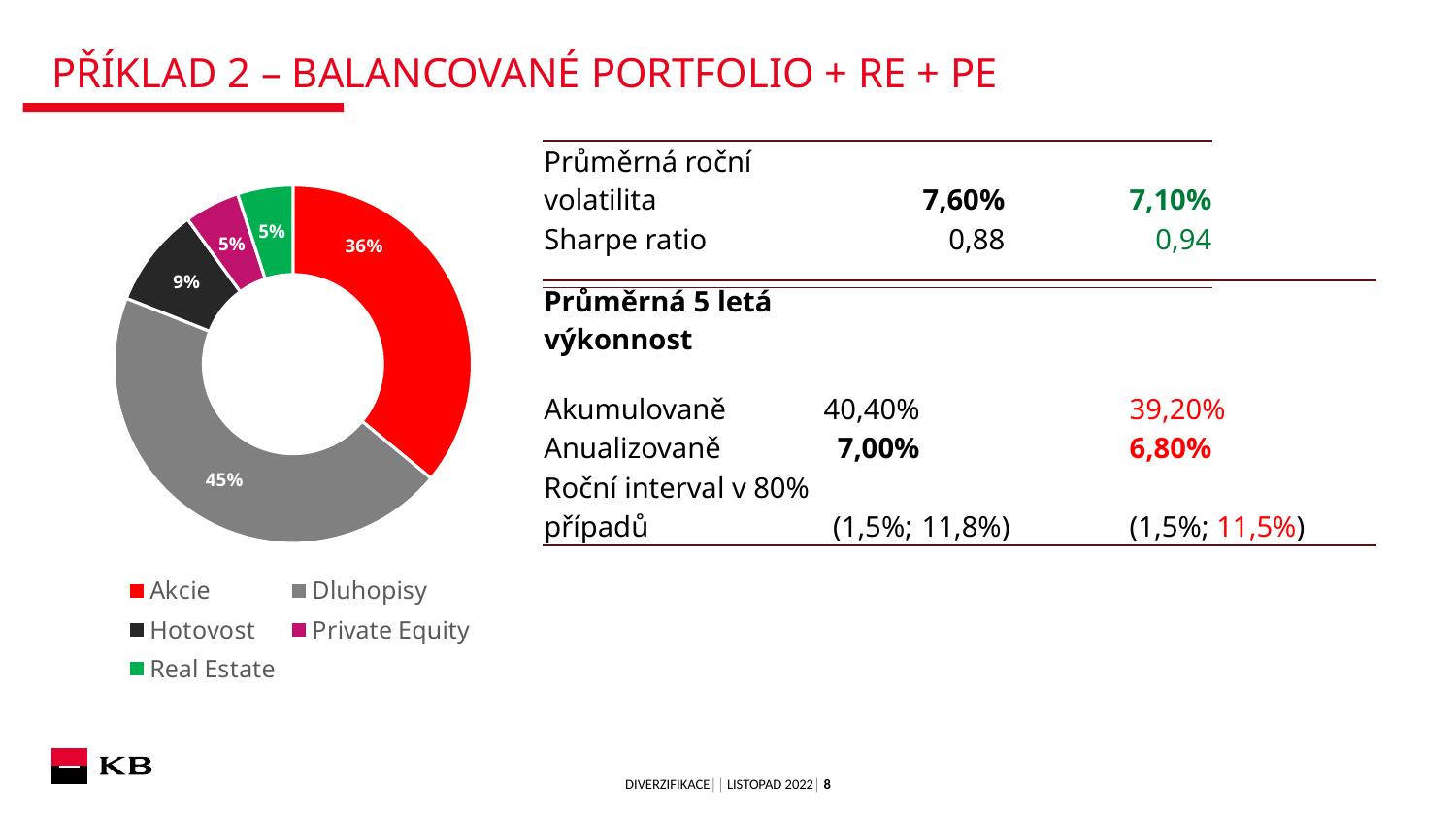
What is the combined share of Akcie and Dluhopisy in the pie chart? 81% What share of the portfolio is Dluhopisy in the pie chart? 45% What is the difference in percentage points between the Dluhopisy slice and the Akcie slice? 9 percentage points Which category has the largest slice in the pie chart? Dluhopisy What kind of chart is shown on the slide? Doughnut chart What share of the portfolio is Akcie in the pie chart? 36% How many slices does the pie chart have? 5 How many entries does the legend of the pie chart list? 5 What is the value shown for Real Estate in the pie chart? 5% Which slice is larger in the pie chart, Akcie or Hotovost? Akcie What is the value shown for Hotovost in the pie chart? 9% Which colour represents Akcie in the pie chart? Red